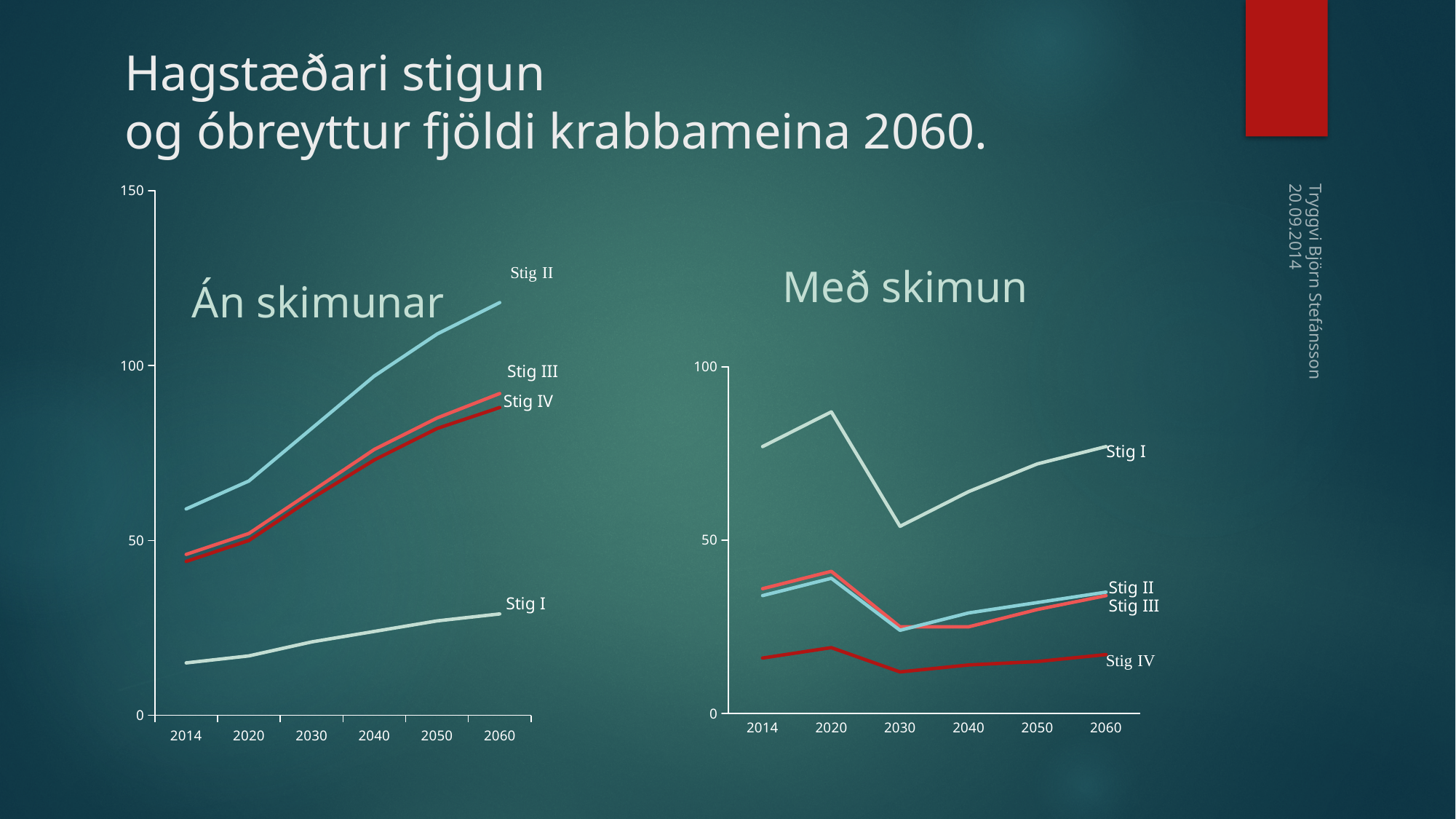
In the 'Með skimun' chart, which is larger in 2060: Stig I or Stig IV? Stig I In the 'Án skimunar' chart, which series has the lowest value in 2060? Stig I In the 'Án skimunar' chart, does the Stig II line rise or fall from 2014 to 2060? rise In the 'Án skimunar' chart, which series has the highest value in 2060? Stig II In the 'Án skimunar' chart, is the value for Stig II in 2060 greater or less than 100? greater In the 'Án skimunar' chart, is the value for Stig I in 2014 greater or less than 50? less How many series are plotted in the 'Með skimun' chart on the right? 4 In the 'Með skimun' chart, which series has the lowest value in 2030? Stig IV In the 'Með skimun' chart, which series has the highest value in 2060? Stig I What kind of chart is the 'Án skimunar' chart on the left? line chart How many years are shown on the x axis of the 'Án skimunar' chart? 6 In the 'Með skimun' chart, is the value for Stig I in 2020 greater or less than 50? greater